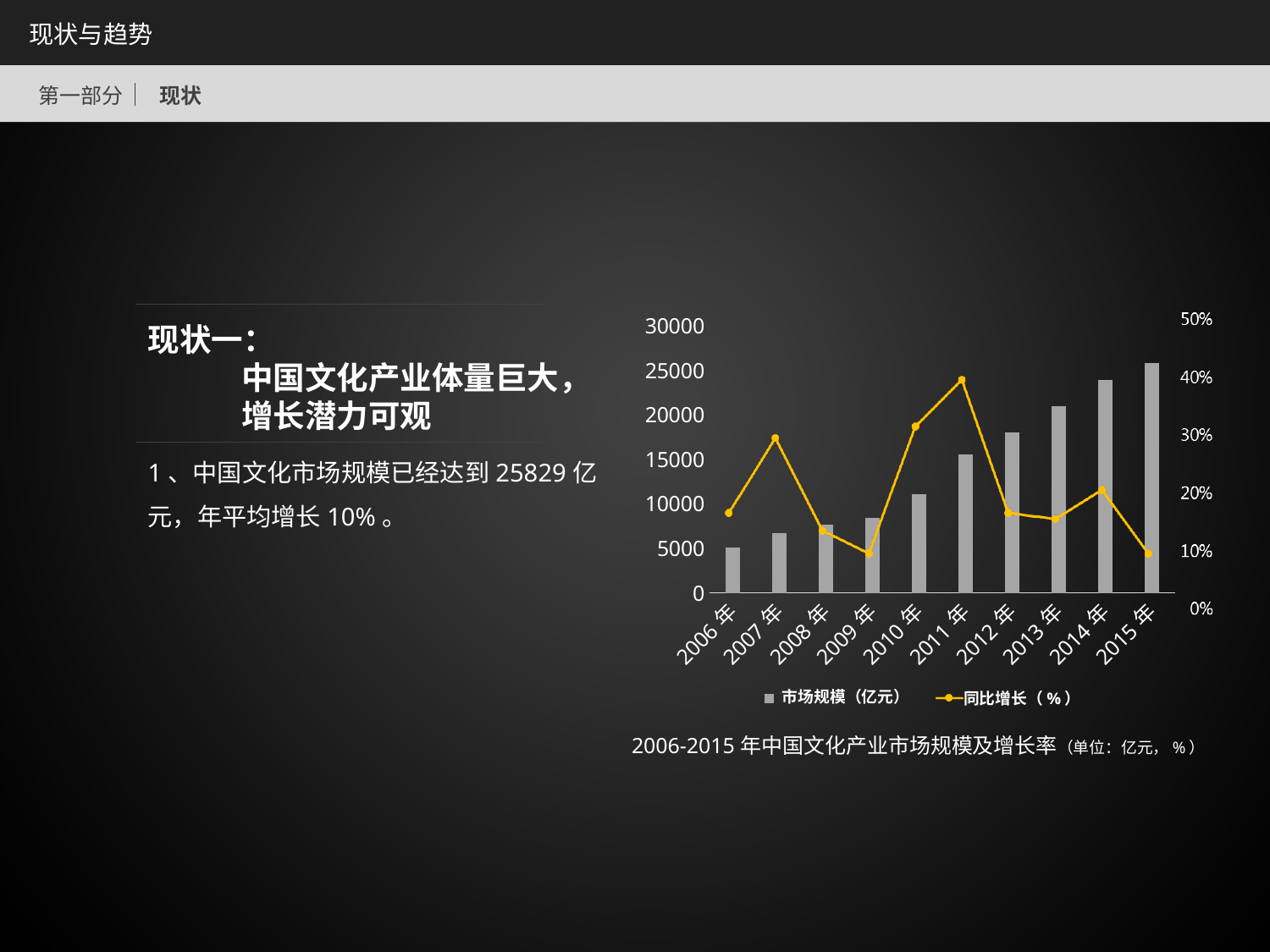
Which year has the shortest 市场规模 bar? 2006 年 How many years are shown on the x axis of the chart? 10 Is the 同比增长 value for 2011 年 greater or less than 30%? greater Do the 市场规模 bars generally rise or fall from 2006 年 to 2015 年? rise How many series does the chart legend list? 2 In which year does the 同比增长 line reach its highest point? 2011 年 Is the 市场规模 bar for 2014 年 greater or less than 25000? less Which year has the larger 市场规模 bar, 2010 年 or 2012 年? 2012 年 Which year has the tallest 市场规模 bar? 2015 年 What kind of chart is shown on the slide? A combined bar and line chart Is the 市场规模 bar for 2009 年 greater or less than 10000? less